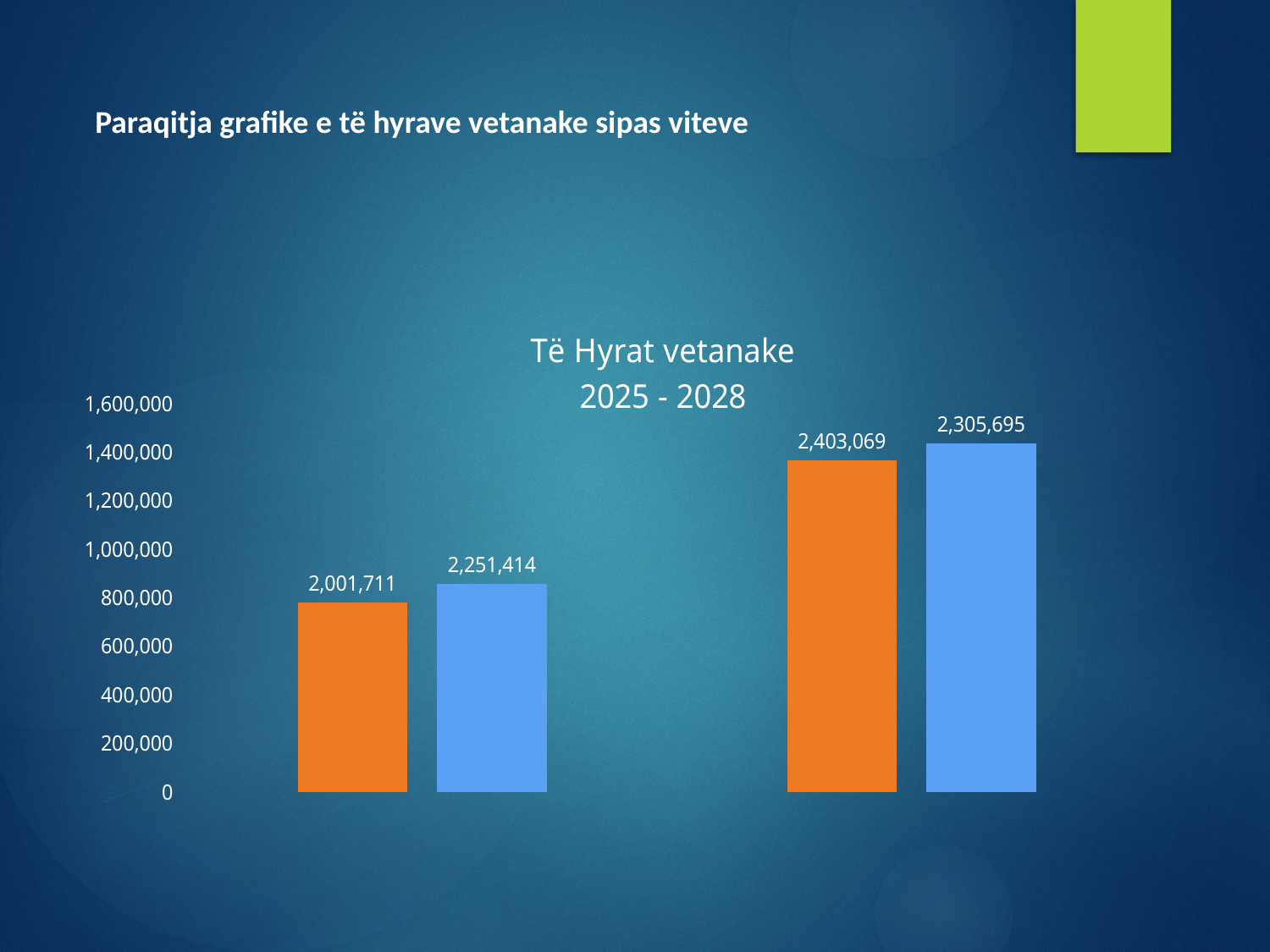
What is the difference between the highest value (2,403,069) and the lowest value (2,001,711)? 401,358 What type of chart is shown on the slide? bar chart Which is larger: the value of the second bar or the value of the fourth bar? the fourth bar (2,305,695) What is the title of the chart? Të Hyrat vetanake 2025 - 2028 What is the value shown on the fourth (rightmost) bar? 2,305,695 Which bar has the lowest value? the first (leftmost) bar (2,001,711) What is the value shown on the second bar from the left? 2,251,414 What is the difference between the third bar (2,403,069) and the fourth bar (2,305,695)? 97,374 How many bars are plotted in the chart? 4 What is the value shown on the first (leftmost) bar? 2,001,711 What is the value shown on the third bar from the left? 2,403,069